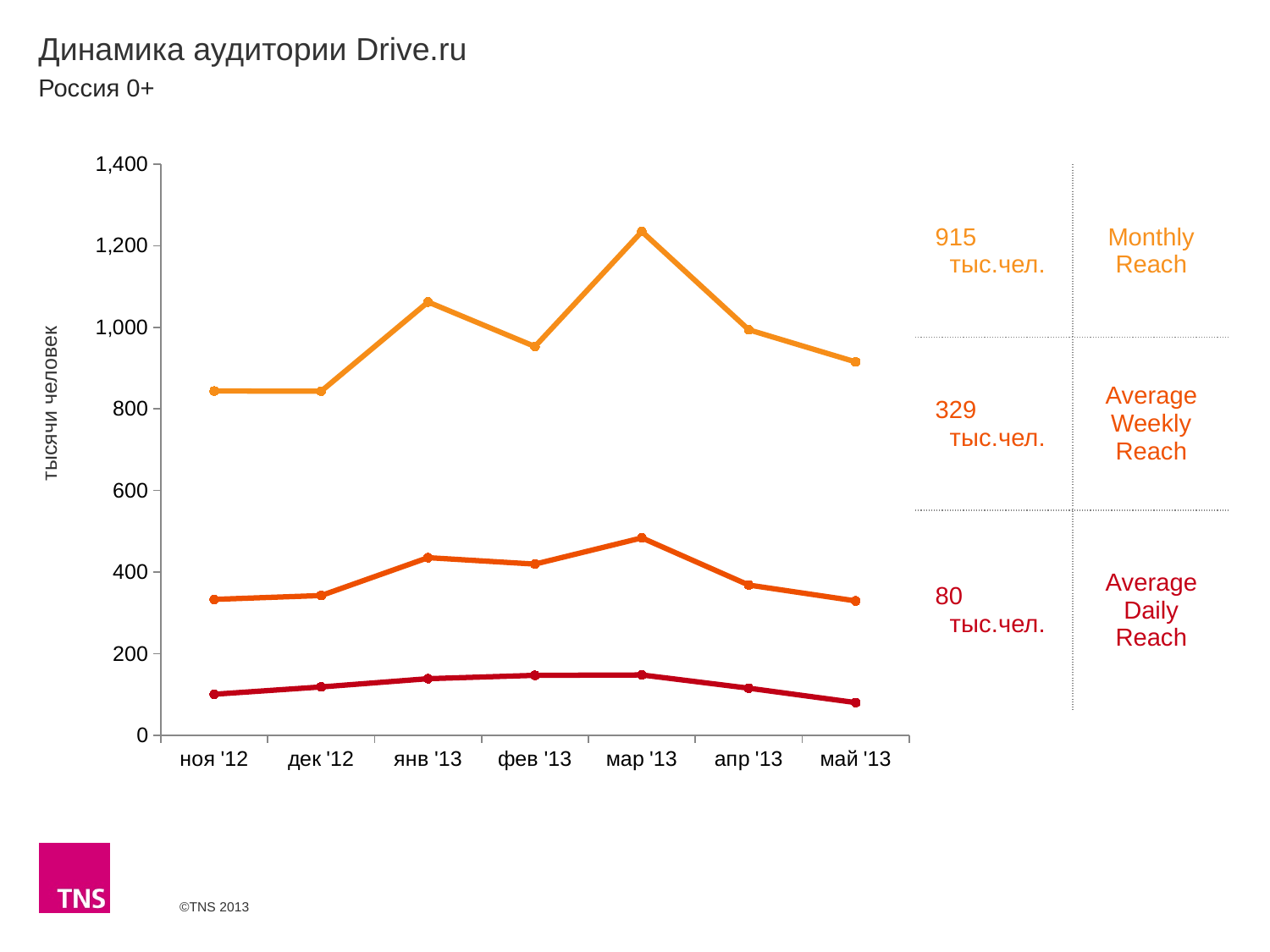
Is the Average Weekly Reach value for янв '13 greater or less than 400? greater Is the Monthly Reach value for мар '13 greater or less than 1,000? greater Does Monthly Reach rise or fall from мар '13 to май '13? fall What is the label on the y axis? тысячи человек What kind of chart is shown on the slide? line chart What Average Daily Reach value is printed on the slide? 80 тыс.чел. In which month does Monthly Reach reach its highest value? мар '13 In which month is Average Daily Reach at its lowest? май '13 What Monthly Reach value is printed on the slide? 915 тыс.чел. Which month has the higher Monthly Reach, янв '13 or фев '13? янв '13 How many months are plotted along the x axis? 7 How many series are shown in the chart? 3